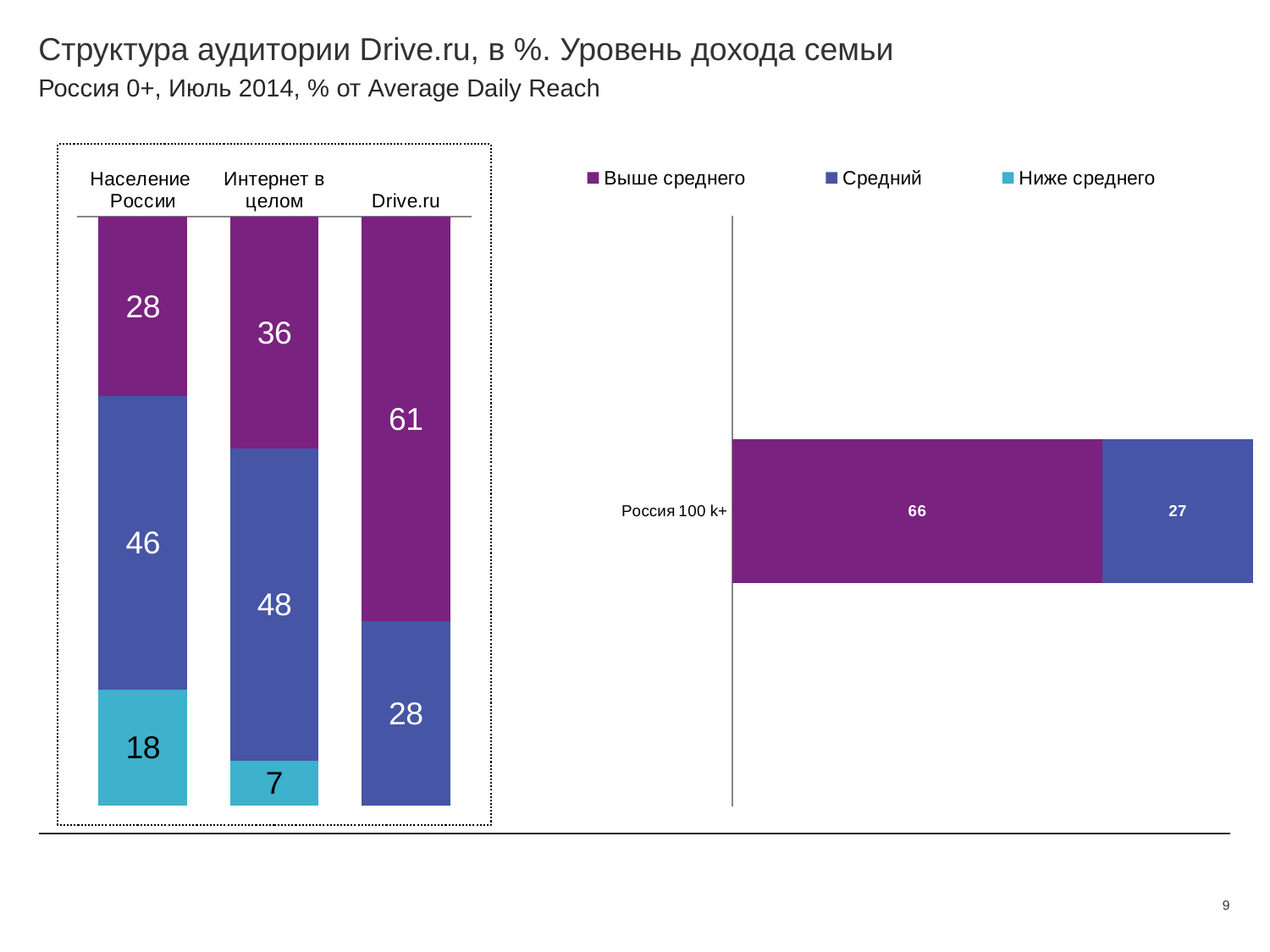
In the right chart, what is the Выше среднего value for Россия 100 k+? 66 In the left chart, what is the difference between the Выше среднего values for Drive.ru and Население России? 33 In the left chart, which category has the highest Выше среднего value? Drive.ru In the left chart, what is the value of the Средний segment for Интернет в целом? 48 What kind of chart is the left chart? Stacked bar chart In the left chart, what is the value of the Ниже среднего segment for Население России? 18 In the left chart, which category has the lowest Ниже среднего value? Интернет в целом How many series does the legend list? 3 In the right chart, what is the Средний value for Россия 100 k+? 27 In the left chart, which is larger: the Средний value for Население России or for Интернет в целом? Интернет в целом How many categories are shown in the left chart? 3 In the left chart, what is the value of the Выше среднего segment for Drive.ru? 61